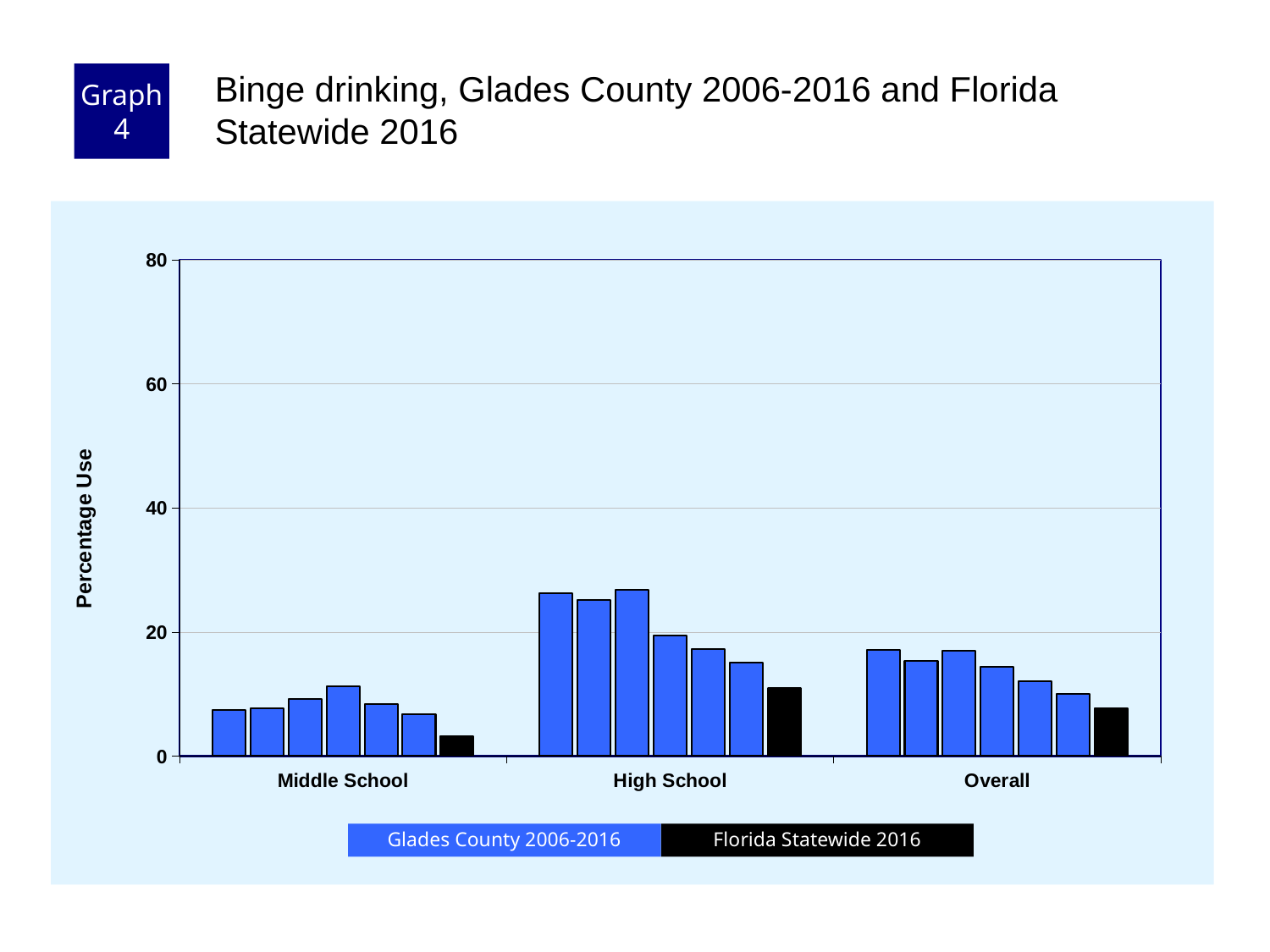
What is the title of the chart? Binge drinking, Glades County 2006-2016 and Florida Statewide 2016 What is the label on the y axis? Percentage Use Is the Florida Statewide 2016 value for Middle School greater or less than 20? less Is the tallest Glades County bar for High School greater or less than 20? greater Which category has the lowest Florida Statewide 2016 value? Middle School Which category has the highest Florida Statewide 2016 value? High School Which is larger, the Florida Statewide 2016 value for High School or for Middle School? High School How many series does the legend list? 2 What kind of chart is shown on the slide? bar chart How many categories are shown on the x axis? 3 Is the Florida Statewide 2016 value for High School greater or less than 20? less